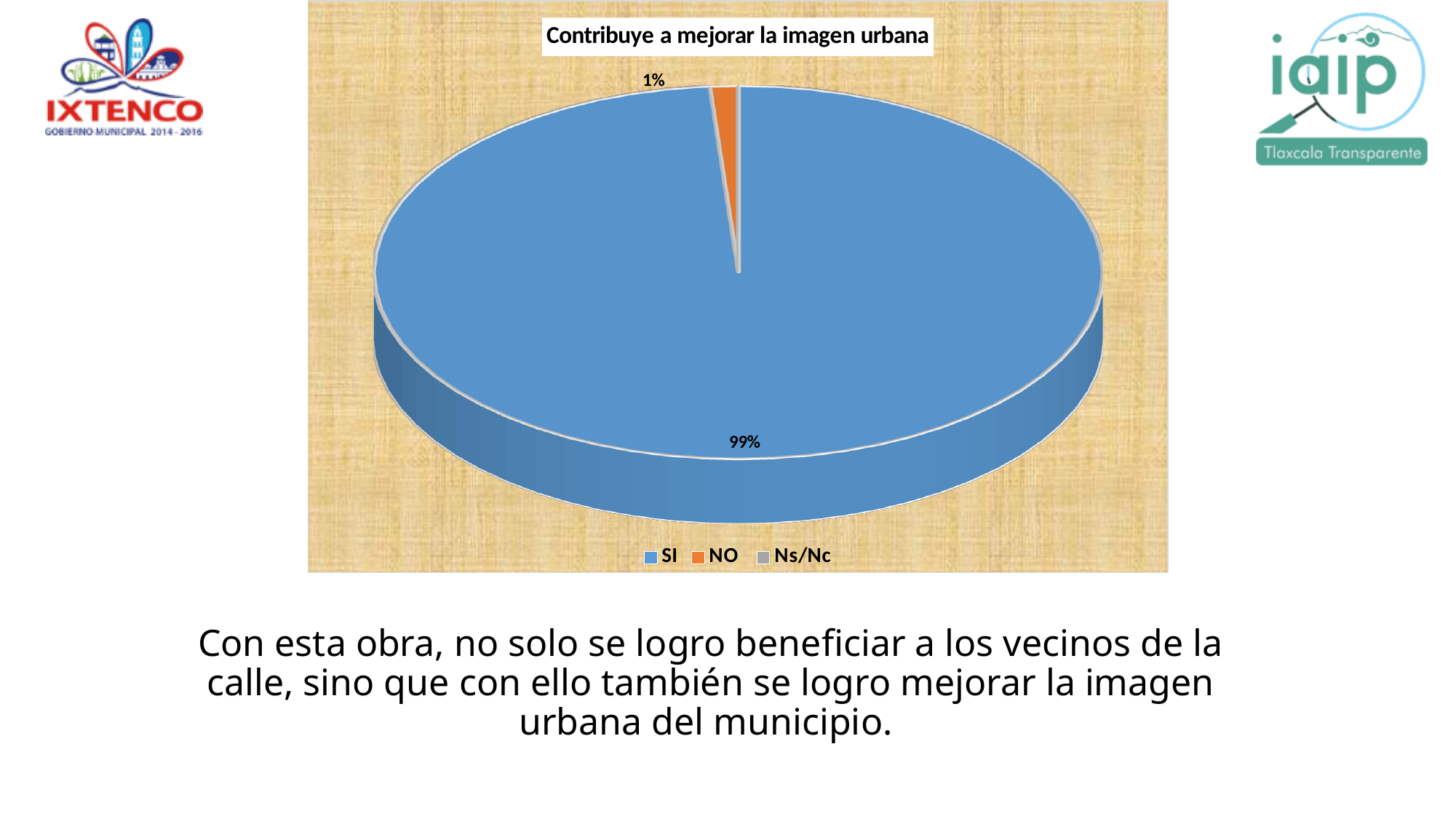
Which of SI or NO has the larger share? SI What percentage of the pie is labelled for SI? 99% How many slices with a printed percentage label are visible in the pie? 2 How many entries does the legend list? 3 Which category has the largest share of the pie? SI What is the difference in percentage points between the SI and NO shares? 98 What is the title of the chart? Contribuye a mejorar la imagen urbana What colour is the SI slice? blue What percentage of the pie is labelled for NO? 1% What kind of chart is shown on the slide? pie chart